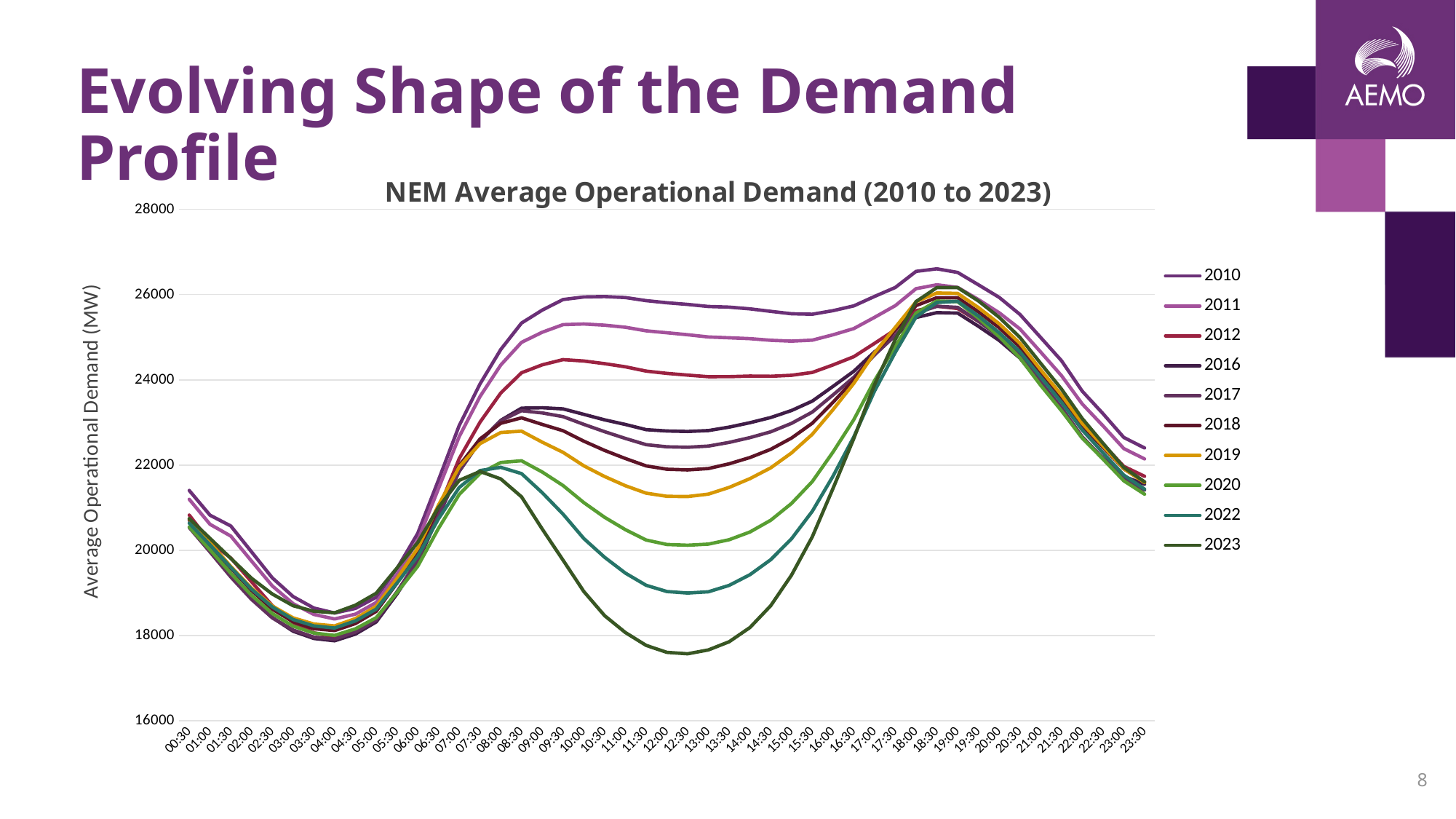
Is the value for 2023 at 12:30 greater or less than 18000? less Is the value for 2022 at 12:30 greater or less than 20000? less At 12:00, which is larger: the value for 2019 or the value for 2022? 2019 How many series does the legend list? 10 Does the 2023 line rise or fall between 08:00 and 12:30? Fall Is the value for 2010 at 18:30 greater or less than 26000? greater What kind of chart is shown on the slide? Line chart Which series has the lowest value at 12:00? 2023 What is the title of the chart? NEM Average Operational Demand (2010 to 2023) Which series has the highest value at 12:00? 2010 What is the label on the vertical axis? Average Operational Demand (MW)